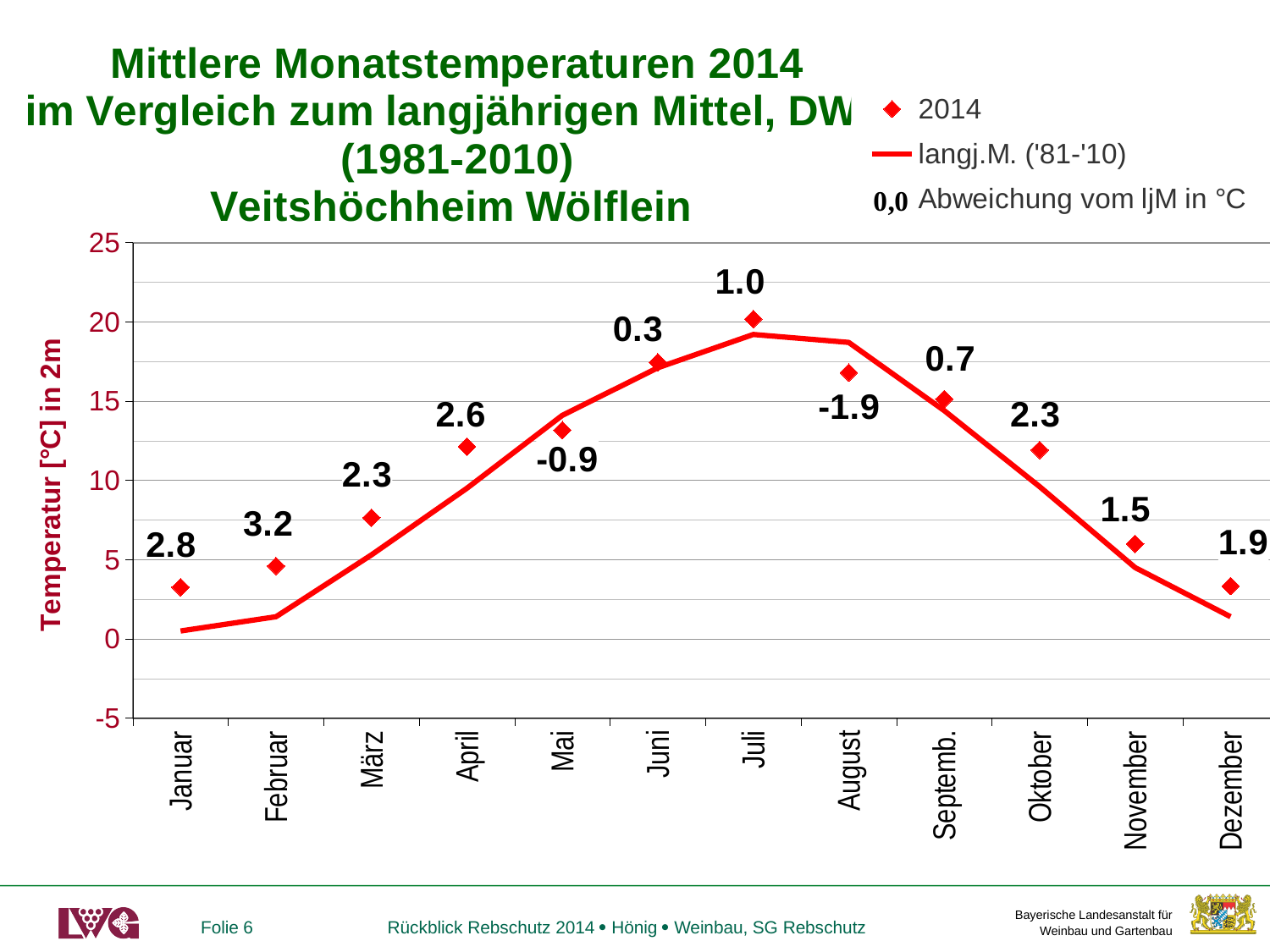
Is the long-term mean (langj.M.) value for Januar greater or less than 5? less What is the labelled deviation from the long-term mean for Mai? -0.9 Is the 2014 value for Juli greater or less than 15? greater What is the labelled deviation from the long-term mean for August? -1.9 How many months are shown on the x axis? 12 Which month has the larger labelled deviation, März or April? April Do the 2014 values rise or fall from Januar to Juli? rise What is the difference between the labelled deviations for Februar and Januar? 0.4 Which month has the highest labelled deviation from the long-term mean? Februar Which month has the lowest labelled deviation from the long-term mean? August What is the title of the y axis? Temperatur [°C] in 2m What is the labelled deviation from the long-term mean (Abweichung) for Februar? 3.2